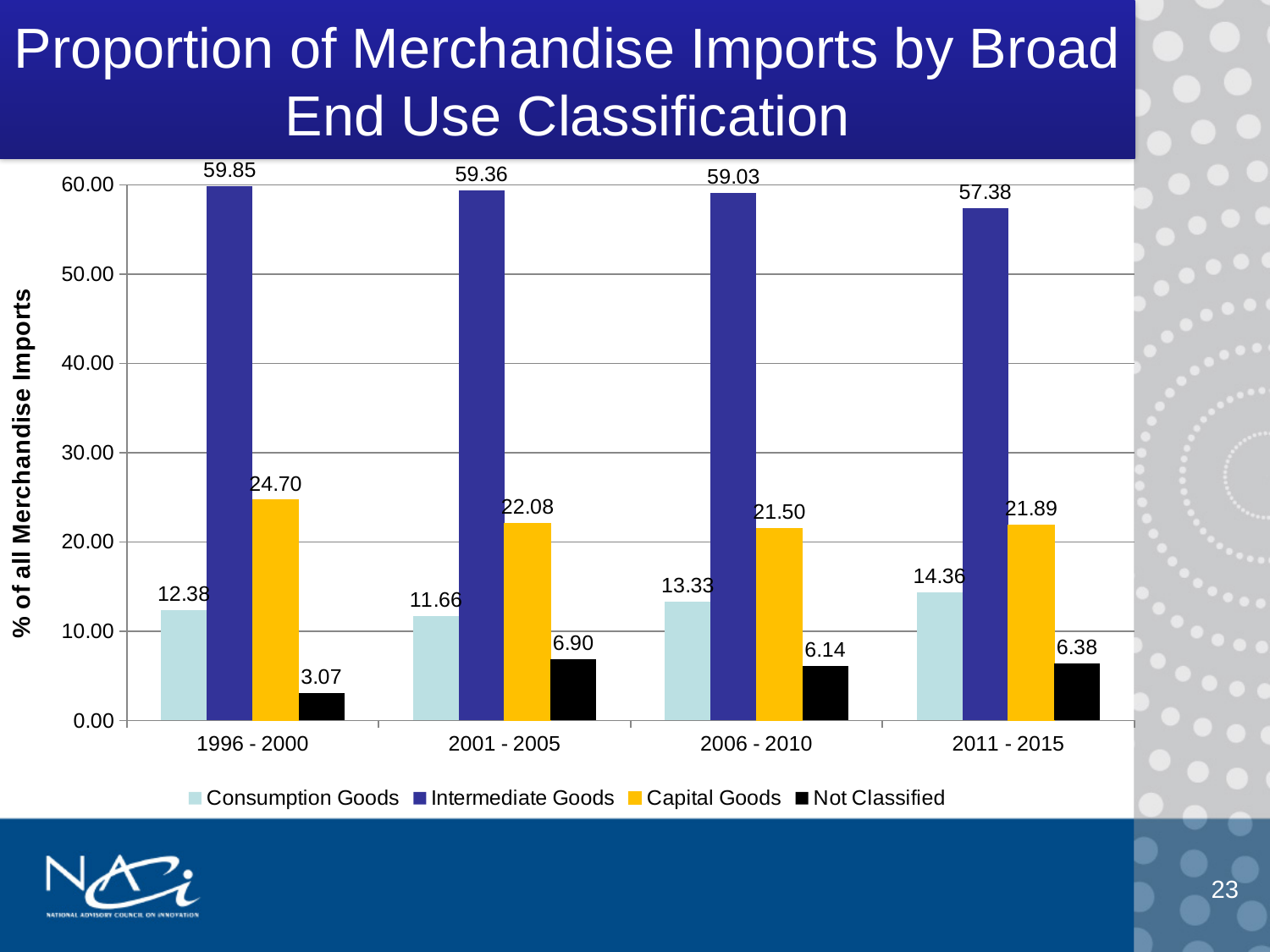
In which period is the Intermediate Goods value highest? 1996 - 2000 What kind of chart is shown on the slide? Bar chart Does the Intermediate Goods value rise or fall across the periods from 1996 - 2000 to 2011 - 2015? Fall What is the value for Intermediate Goods in 1996 - 2000? 59.85 What is the value for Not Classified in 2001 - 2005? 6.90 In which period is the Consumption Goods value lowest? 2001 - 2005 What is the difference between the Capital Goods values for 1996 - 2000 and 2001 - 2005? 2.62 What is the value for Capital Goods in 2006 - 2010? 21.50 How many series does the legend list? 4 What is the value for Consumption Goods in 2011 - 2015? 14.36 Which is larger, the Not Classified value in 2006 - 2010 or in 2011 - 2015? 2011 - 2015 How many periods are shown on the x axis? 4